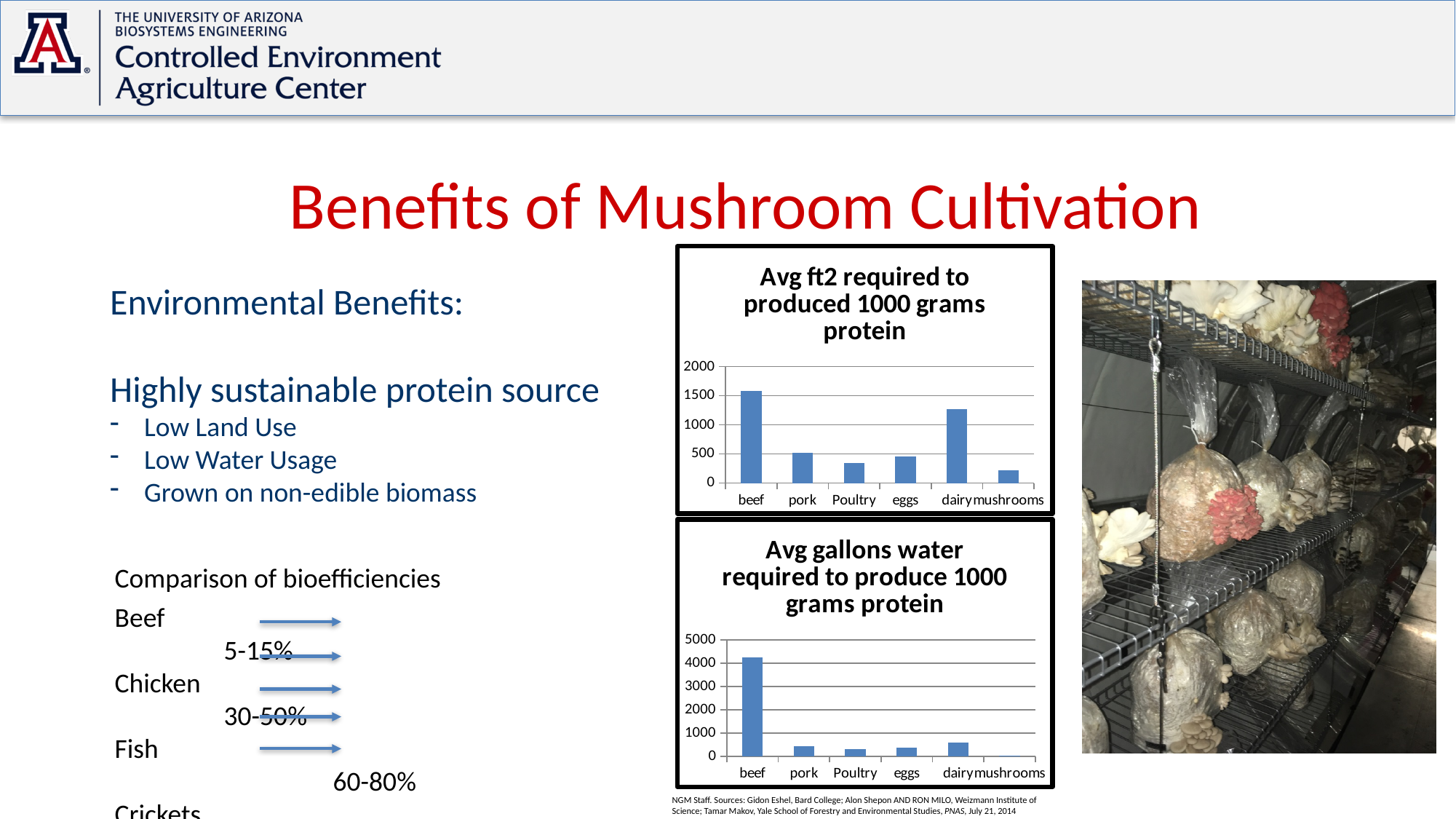
In the chart titled 'Avg gallons water required to produce 1000 grams protein', is the value for dairy greater or less than 1000? less In the chart titled 'Avg gallons water required to produce 1000 grams protein', which category has the lowest value? mushrooms In the chart titled 'Avg ft2 required to produced 1000 grams protein', how many categories are plotted? 6 In the chart titled 'Avg ft2 required to produced 1000 grams protein', which category has the highest value? beef In the chart titled 'Avg gallons water required to produce 1000 grams protein', which category has the highest value? beef In the chart titled 'Avg gallons water required to produce 1000 grams protein', is the value for beef greater or less than 4000? greater In the chart titled 'Avg ft2 required to produced 1000 grams protein', which category has the lowest value? mushrooms In the chart titled 'Avg ft2 required to produced 1000 grams protein', what kind of chart is shown? bar chart In the chart titled 'Avg ft2 required to produced 1000 grams protein', is the value for mushrooms greater or less than 500? less In the chart titled 'Avg ft2 required to produced 1000 grams protein', which is larger, the value for dairy or the value for pork? dairy In the chart titled 'Avg gallons water required to produce 1000 grams protein', which is larger, the value for beef or the value for dairy? beef